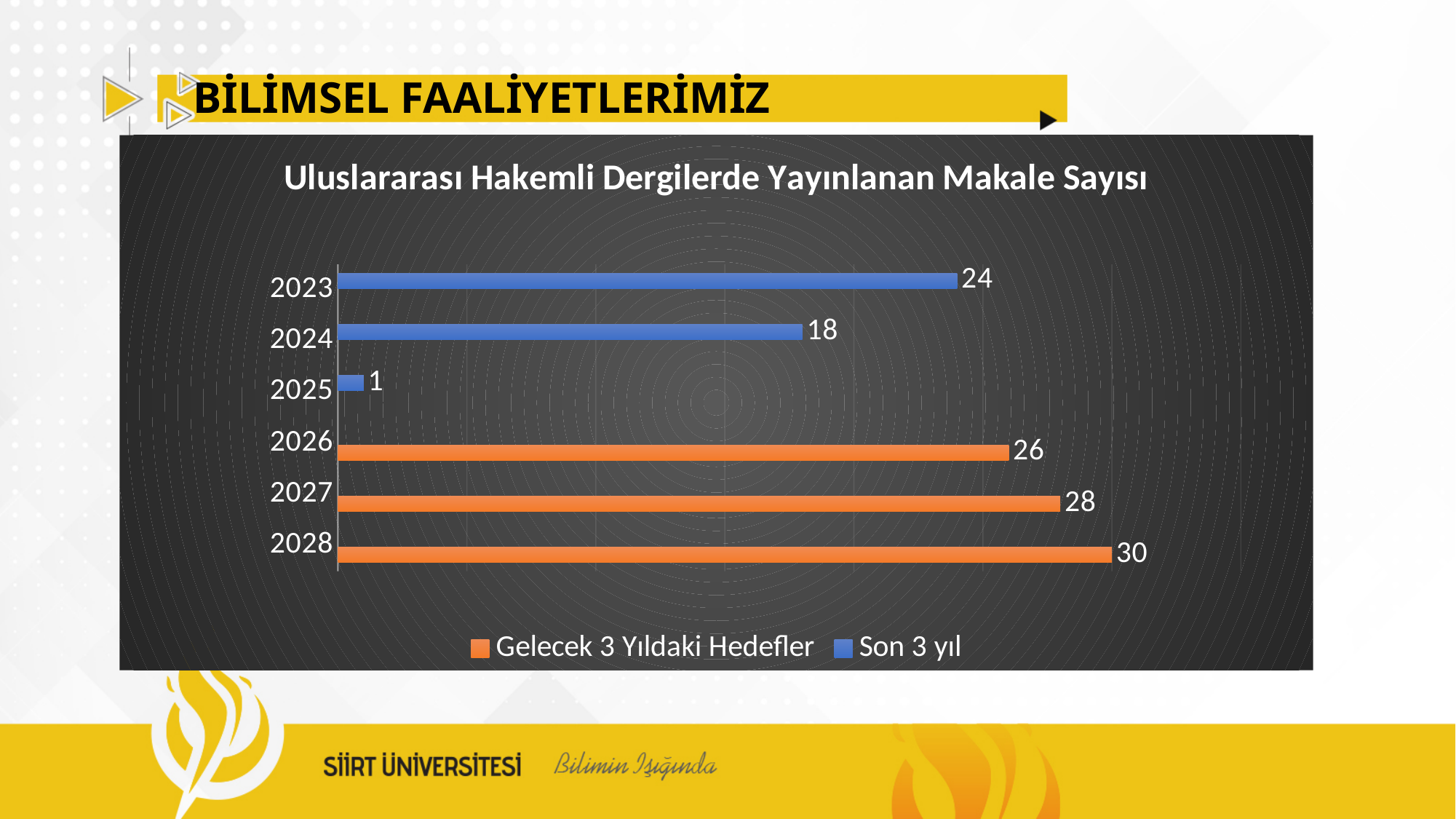
How many series does the legend list? 2 What is the value for 2025 in the chart? 1 What is the difference between the values for 2023 and 2024? 6 Which is larger, the value for 2023 or the value for 2026? 2026 What is the difference between the values for 2027 and 2026? 2 What is the value for 2028 in the chart? 30 What kind of chart is shown on the slide? Bar chart Which year has the highest value in the chart? 2028 What is the value for 2024 in the chart? 18 Which year has the lowest value in the chart? 2025 How many years are shown in the chart? 6 What is the value for 2023 in the chart? 24